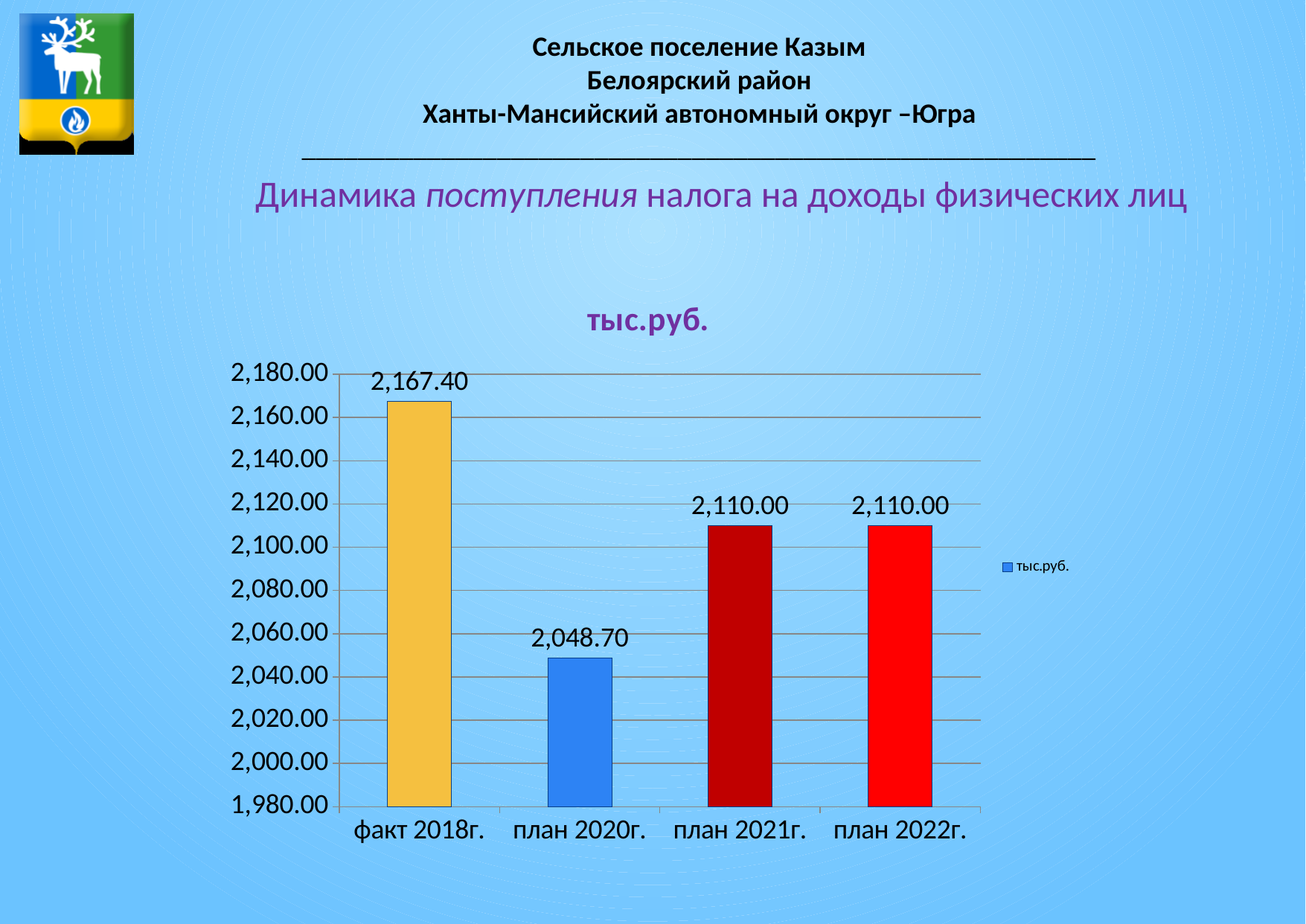
Which category has the highest value? факт 2018г. What is the value for план 2021г.? 2,110.00 What is the difference between the values for факт 2018г. and план 2020г.? 118.70 What is the value for план 2020г.? 2,048.70 What kind of chart is shown on the slide? bar chart Is the value for план 2020г. greater or less than 2,060.00? less Which is larger, the value for факт 2018г. or the value for план 2022г.? факт 2018г. What is the difference between the values for план 2021г. and план 2020г.? 61.30 Which category has the lowest value? план 2020г. How many categories are shown on the x axis? 4 What is the title shown above the chart? тыс.руб. What is the value for факт 2018г.? 2,167.40